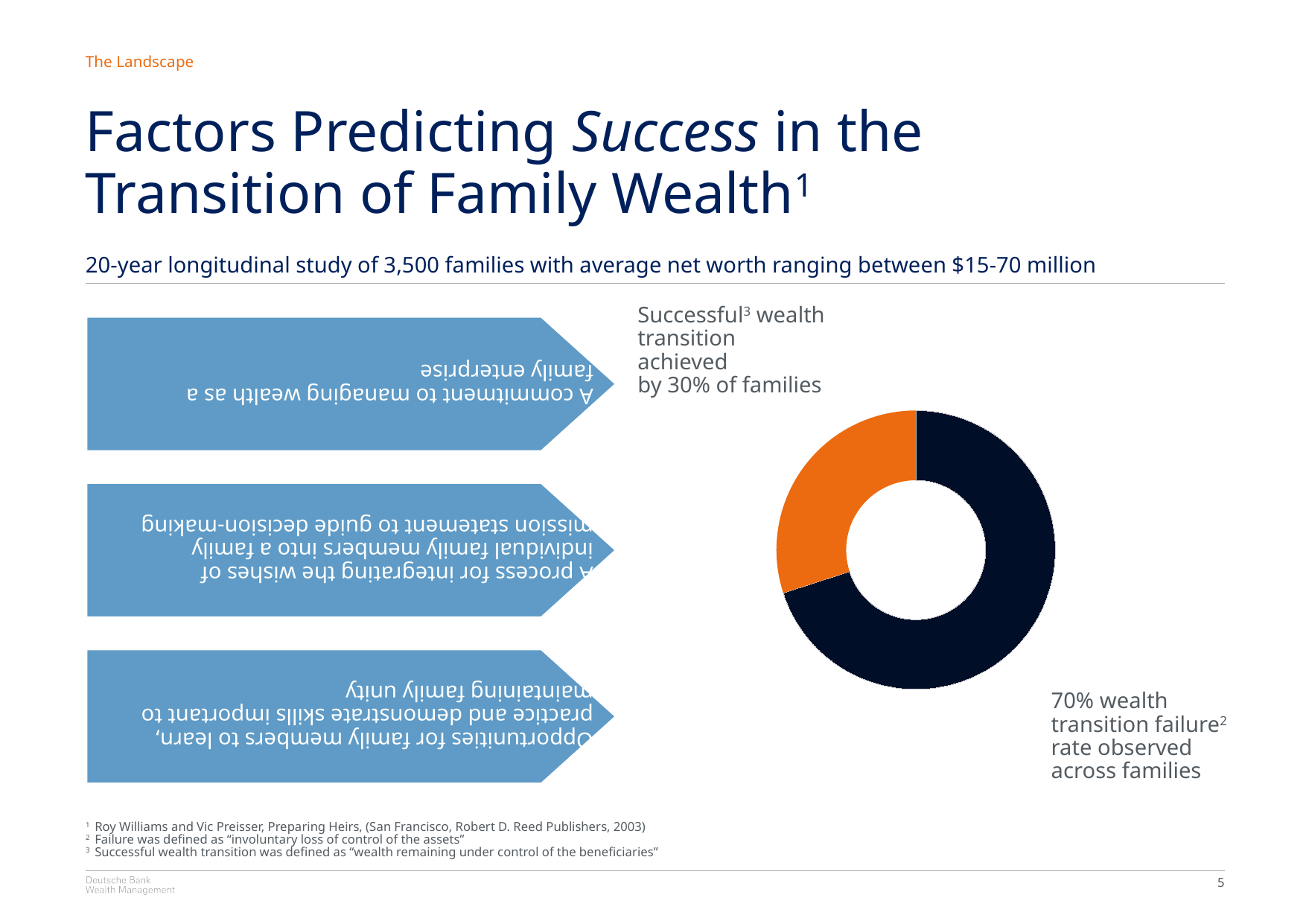
Do the two slices of the donut chart add up to 100%? Yes What percentage of families achieved successful wealth transition according to the chart? 30% Which slice of the donut chart is larger: successful wealth transition or wealth transition failure? Wealth transition failure What is the difference in percentage points between the wealth transition failure rate and the successful transition rate? 40 percentage points Which outcome represents the smallest share of the donut chart? Successful wealth transition (30%) What colour is the slice representing wealth transition failure? Dark navy Which outcome represents the largest share of the donut chart? Wealth transition failure (70%) What share of the donut chart represents families that achieved successful wealth transition? 30% What colour is the slice representing successful wealth transition? Orange What kind of chart is shown on the slide? Donut (pie) chart What wealth transition failure rate is shown on the chart? 70% How many slices does the donut chart have? 2